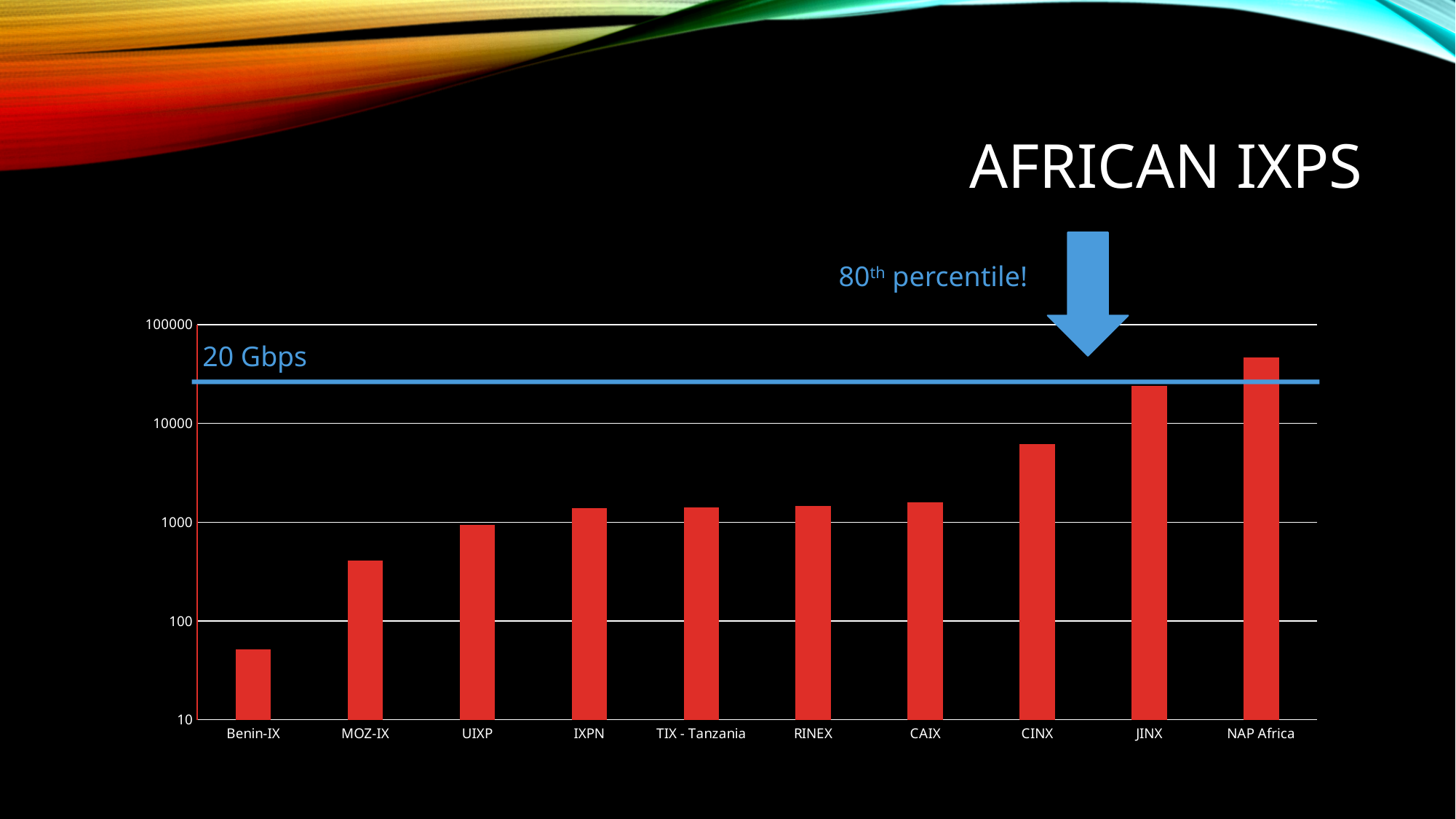
Which IXP has the lowest bar on the chart? Benin-IX Is the value for MOZ-IX greater or less than 1000? less Do the bar values generally rise or fall from left to right along the x axis? rise Is the value for NAP Africa greater or less than 100000? less What kind of chart is shown on the slide? bar chart Is the value for Benin-IX greater or less than 100? less Which is larger, the value for CINX or the value for JINX? JINX Which IXP has the highest bar on the chart? NAP Africa What label is written on the horizontal blue line drawn across the chart? 20 Gbps How many IXPs (categories) are plotted on the chart? 10